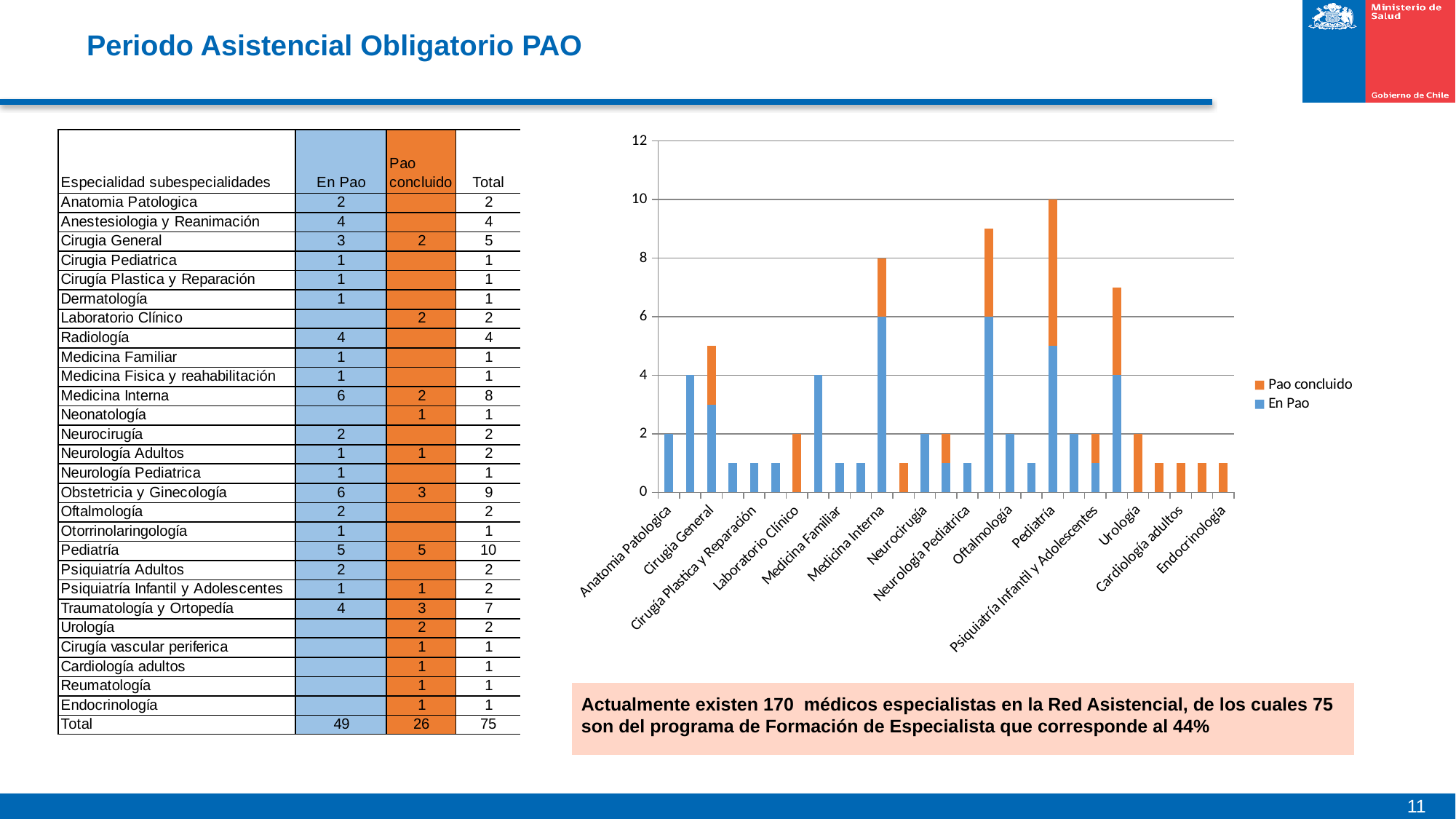
What is the En Pao value for Medicina Interna in the chart? 6 What is the Pao concluido value for Urología in the chart? 2 How many series does the chart legend list? 2 What is the Pao concluido value for Laboratorio Clínico in the chart? 2 Which specialty has the tallest stacked bar in the chart? Pediatría Which has a larger En Pao value, Medicina Familiar or Anatomia Patologica? Anatomia Patologica What kind of chart is shown on the slide? Stacked bar chart What are the two series named in the chart legend? Pao concluido and En Pao Is the total bar height for Cirugia General greater or less than 4? greater What is the total height of the stacked bar for Medicina Interna? 8 What is the total height of the stacked bar for Pediatría? 10 What is the difference between the total bar heights of Pediatría and Medicina Interna? 2